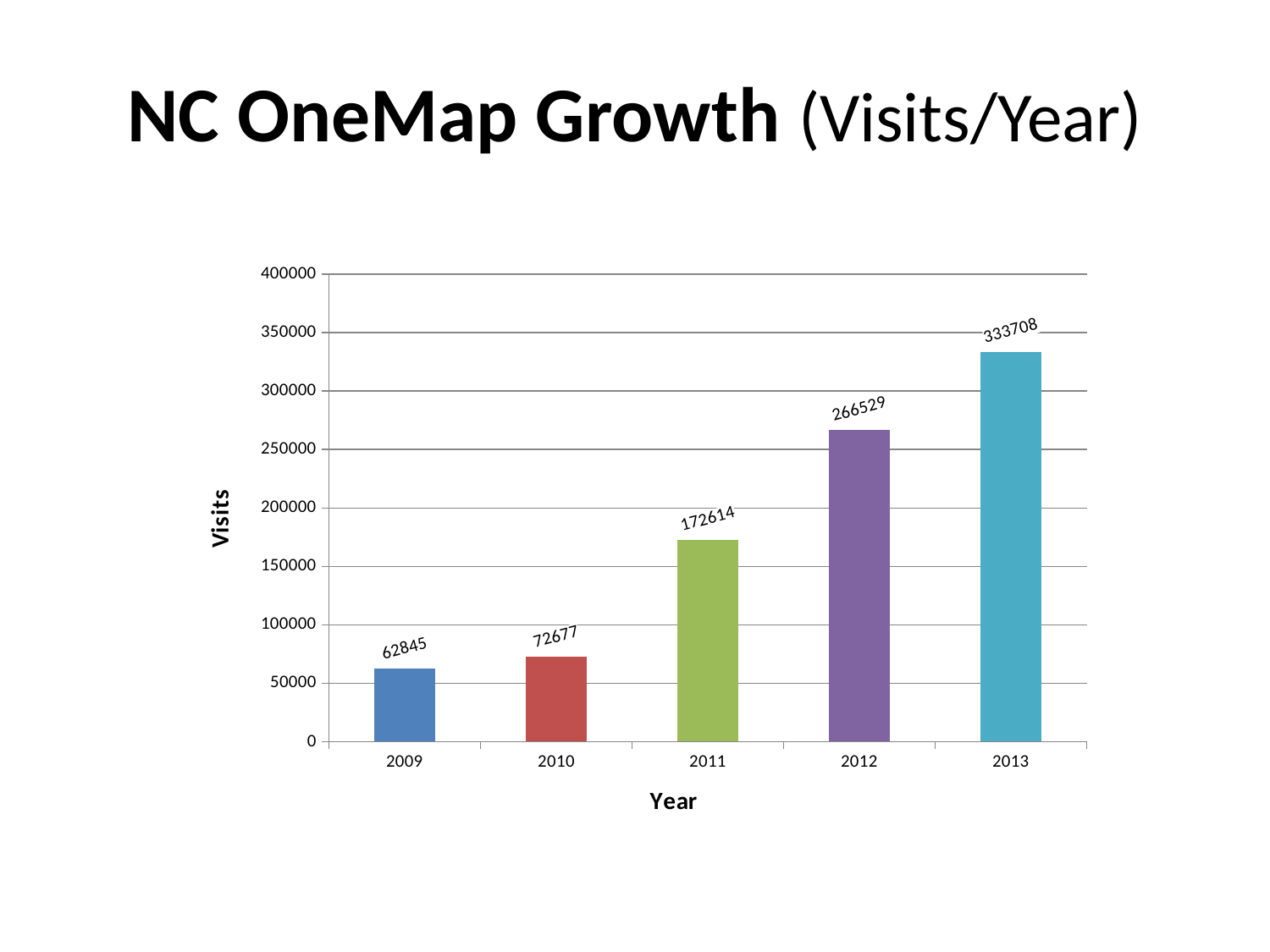
Which year had more visits, 2011 or 2012? 2012 What kind of chart is shown on the slide? bar chart How many visits were there in 2011? 172614 Which year has the lowest number of visits? 2009 How many years are shown on the chart? 5 Do the visits rise or fall from 2009 to 2013? rise Is the value for 2012 greater or less than 250000? greater What is the difference in visits between 2010 and 2009? 9832 What is the value for 2009? 62845 What is the difference in visits between 2013 and 2012? 67179 What is the value for 2013? 333708 Which year has the highest number of visits? 2013